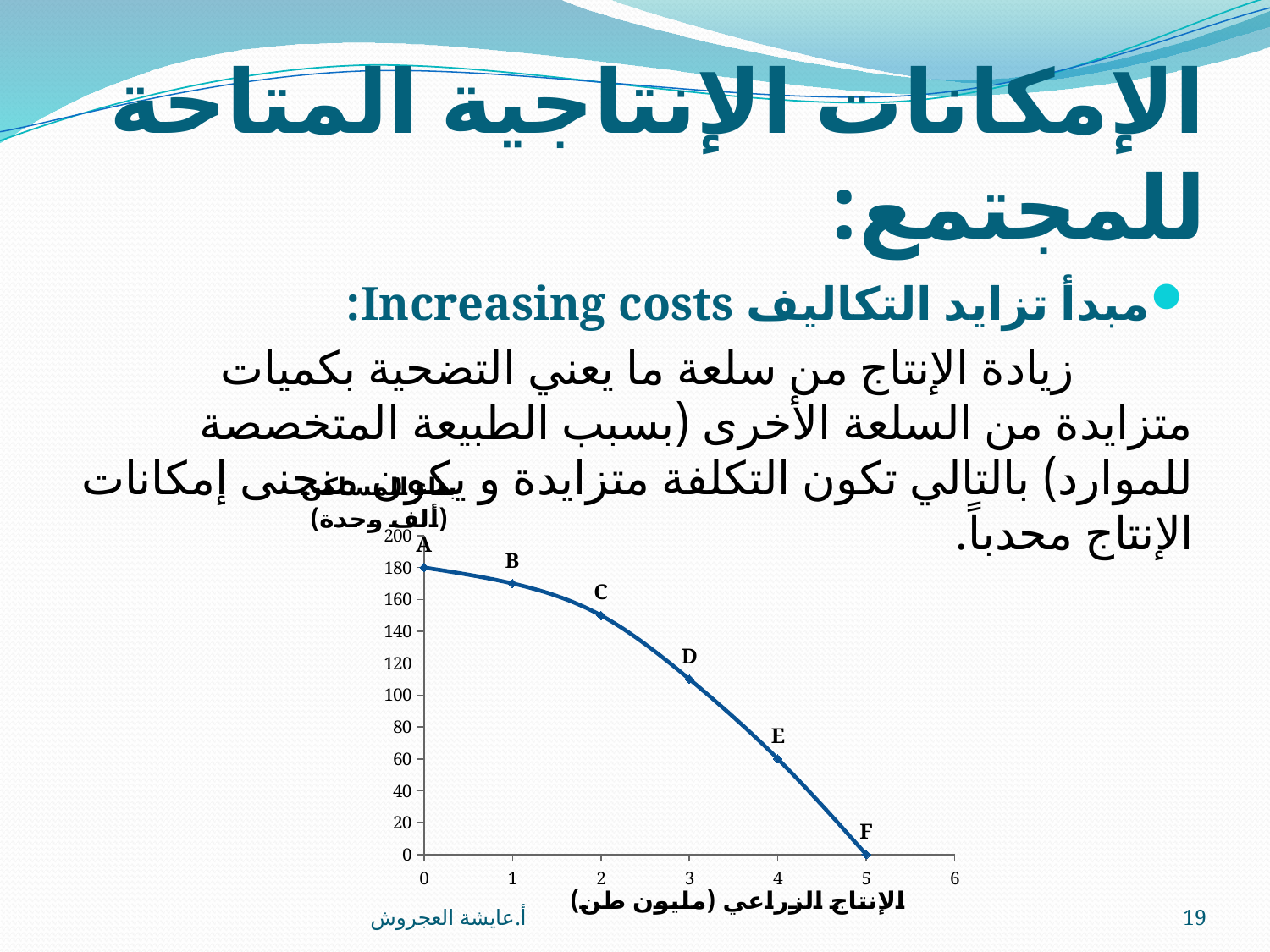
Do the values on the curve rise or fall as the horizontal-axis value increases? fall Is the vertical-axis value at point C greater or less than 140? greater What is the vertical-axis value at point A? 180 What kind of chart is shown on the slide? line chart What is the vertical-axis value at point F? 0 What is the vertical-axis value at point E? 60 How many labelled points are plotted on the curve? 6 Which labelled point has the highest vertical-axis value? A Which point has a larger vertical-axis value, B or E? B What is the horizontal-axis value (agricultural output, million tons) at point D? 3 Which labelled point has the lowest vertical-axis value? F Is the vertical-axis value at point D greater or less than 120? less